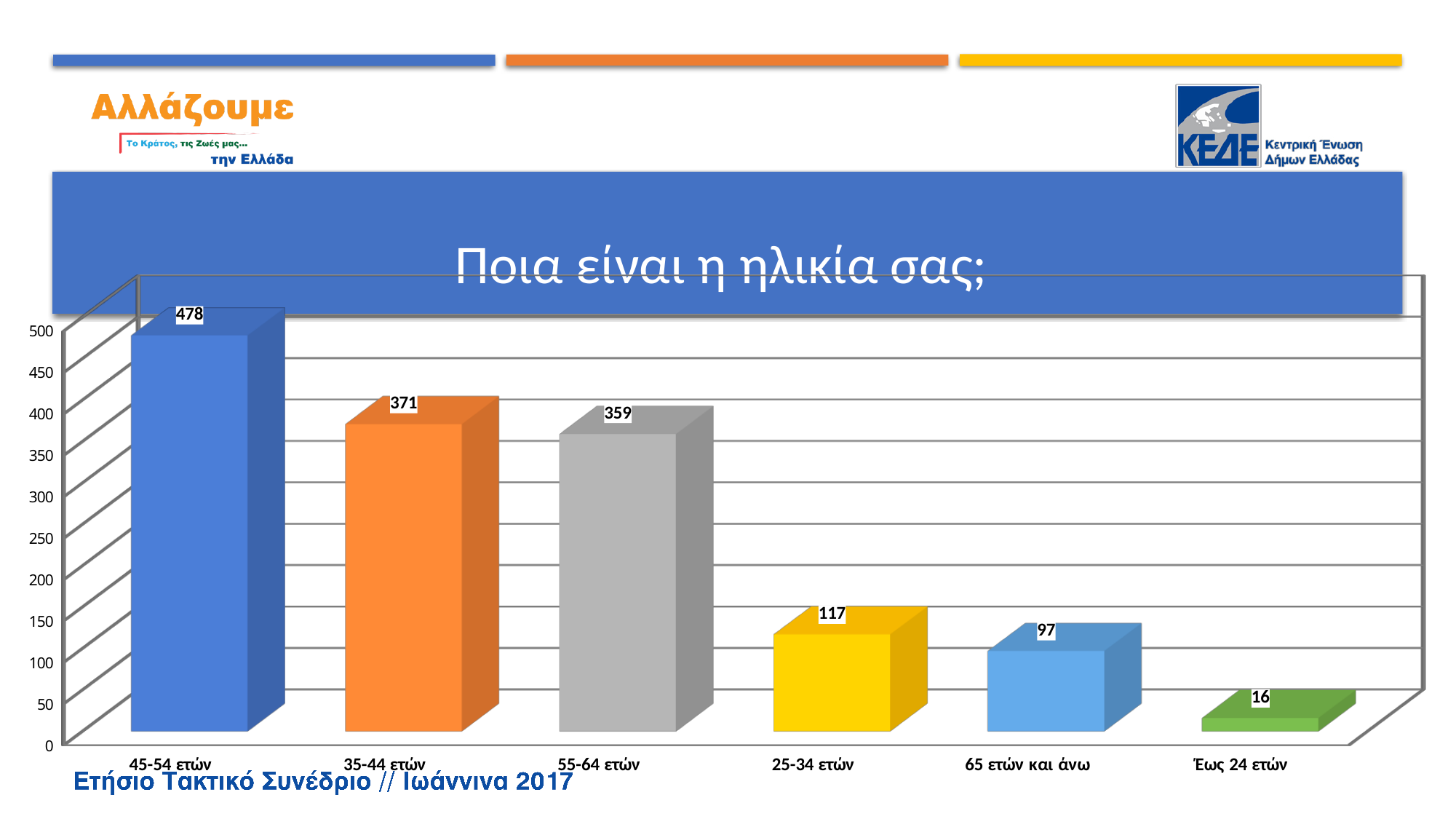
What is the value for the 45-54 ετών category? 478 Which age category has the lowest value? Έως 24 ετών How many age categories are shown in the chart? 6 Is the value for 55-64 ετών greater or less than 300? greater What is the title of the chart? Ποια είναι η ηλικία σας; Which is larger, the value for 25-34 ετών or the value for 65 ετών και άνω? 25-34 ετών Which age category has the highest value? 45-54 ετών What is the value for the 65 ετών και άνω category? 97 What is the value for the 25-34 ετών category? 117 What is the difference between the values for 45-54 ετών and Έως 24 ετών? 462 What kind of chart is shown on the slide? bar chart What is the difference between the values for 35-44 ετών and 55-64 ετών? 12